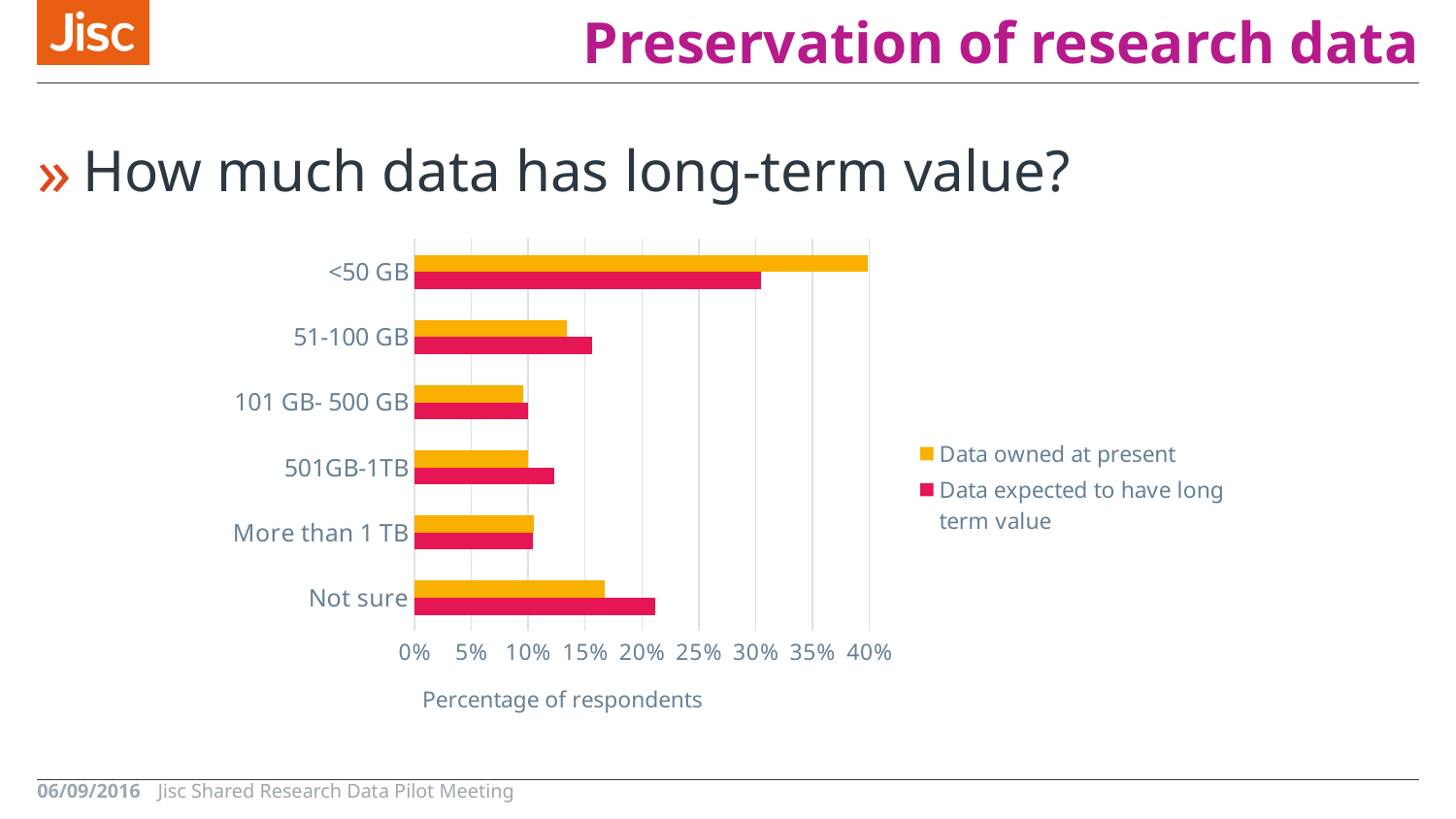
Is the 'Data expected to have long term value' value for Not sure greater or less than 15%? greater How many categories are shown on the chart? 6 What is the label of the horizontal axis? Percentage of respondents For Not sure, which is larger: 'Data owned at present' or 'Data expected to have long term value'? Data expected to have long term value Is the 'Data owned at present' value for 101 GB- 500 GB greater or less than 15%? less What kind of chart is shown on the slide? bar chart For <50 GB, which is larger: 'Data owned at present' or 'Data expected to have long term value'? Data owned at present How many series does the legend list? 2 Is the 'Data owned at present' value for <50 GB greater or less than 35%? greater Which category has the highest value for 'Data owned at present'? <50 GB Which category has the highest value for 'Data expected to have long term value'? <50 GB